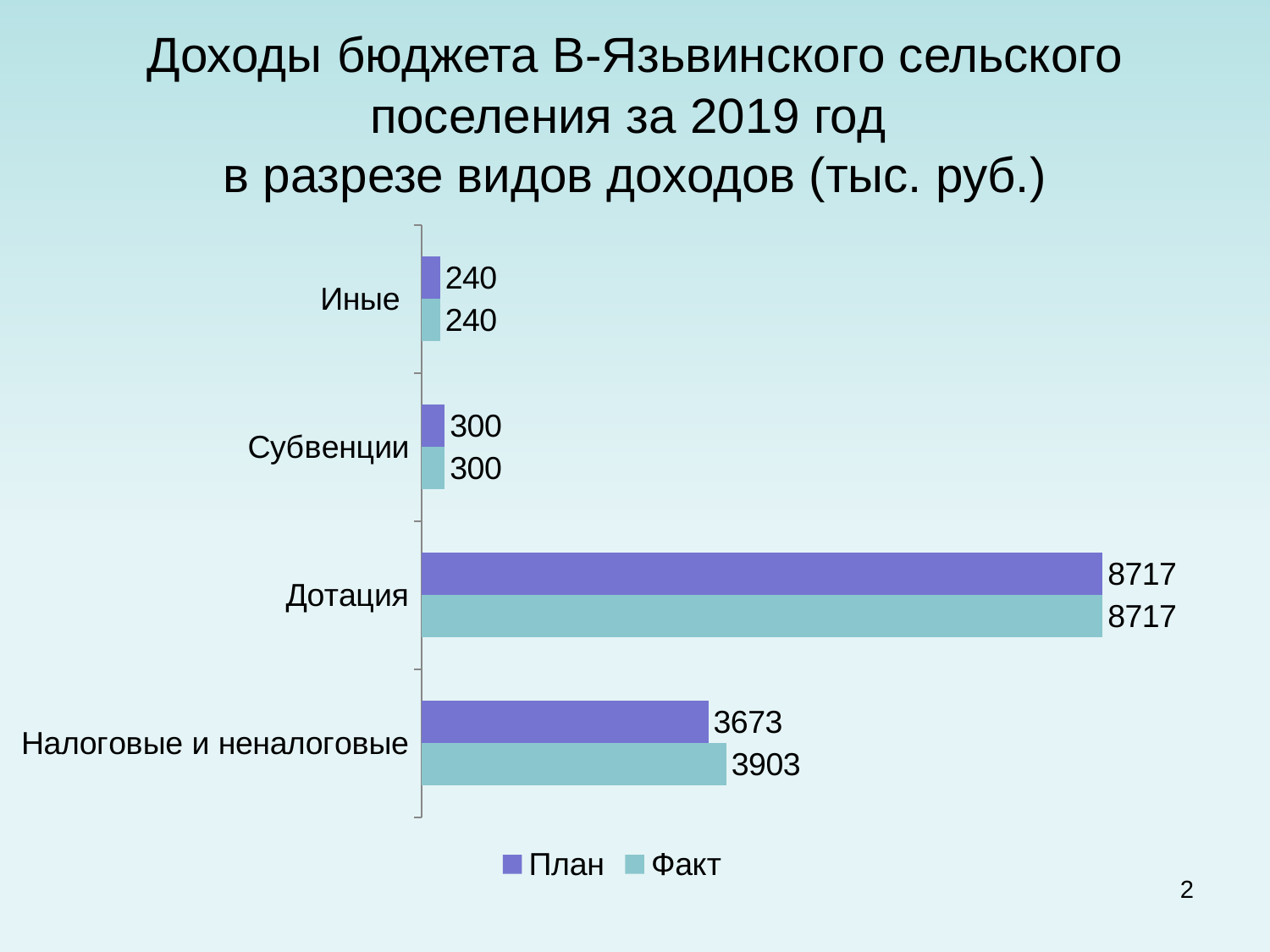
What is the Факт value for Иные? 240 What is the Факт value for Дотация? 8717 How many series does the legend list? 2 Which is larger for Налоговые и неналоговые: the План value or the Факт value? Факт What is the План value for Субвенции? 300 How many categories are shown on the chart? 4 What kind of chart is shown on the slide? Bar chart What is the План value for Налоговые и неналоговые? 3673 What is the Факт value for Налоговые и неналоговые? 3903 Which category has the highest Факт value? Дотация What is the difference between the Факт and План values for Налоговые и неналоговые? 230 Which category has the lowest План value? Иные